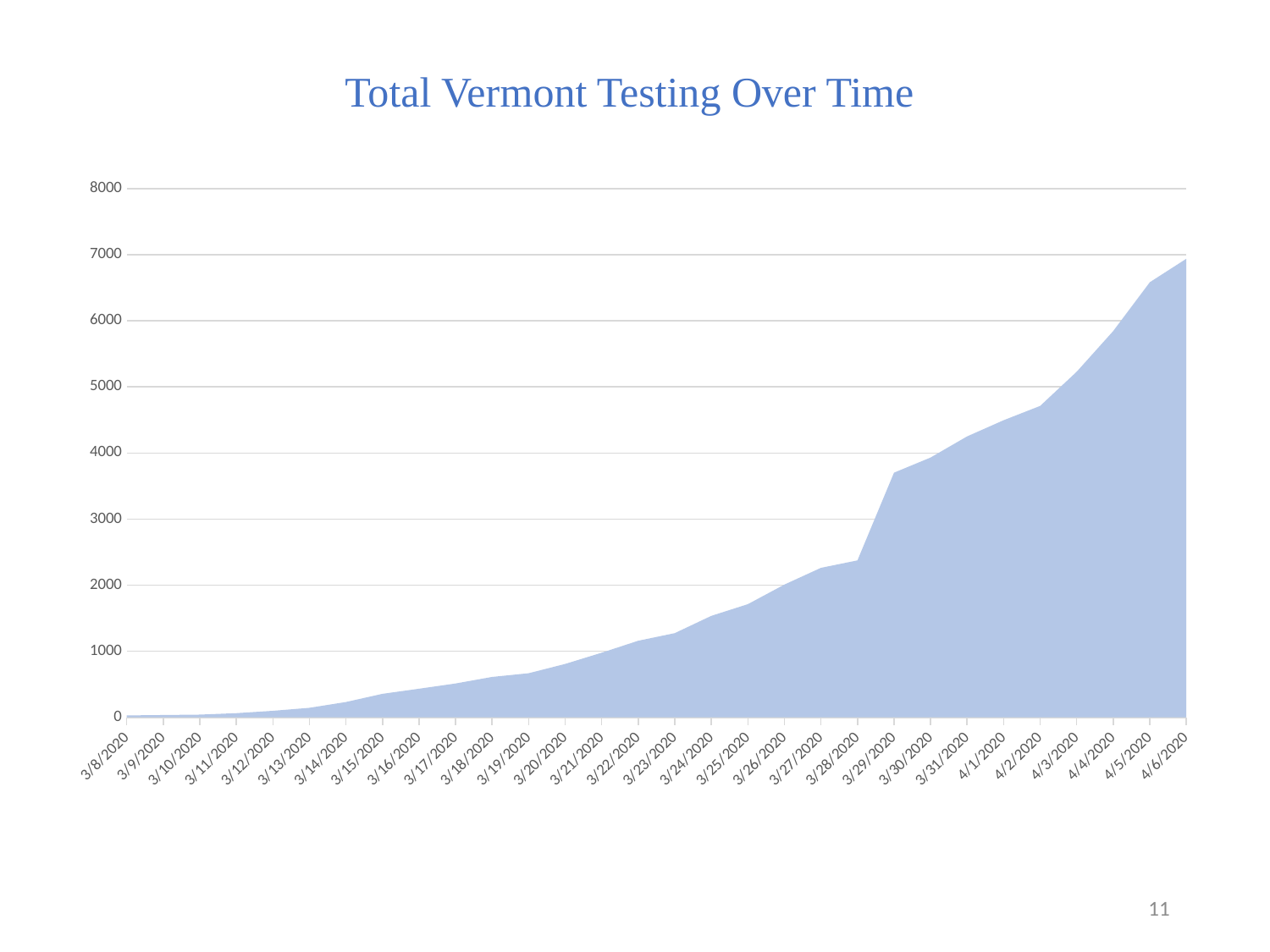
Do the values rise or fall over time from 3/8/2020 to 4/6/2020? Rise Is the value for 3/29/2020 greater or less than 3000? greater How many dates are plotted along the x axis? 30 Which date has the larger value, 3/24/2020 or 4/3/2020? 4/3/2020 Is the value for 4/6/2020 greater or less than 6000? greater Is the value for 3/20/2020 greater or less than 1000? less On which date is the total testing value highest? 4/6/2020 What is the title of the chart? Total Vermont Testing Over Time On which date is the total testing value lowest? 3/8/2020 What kind of chart is shown on the slide? Area chart